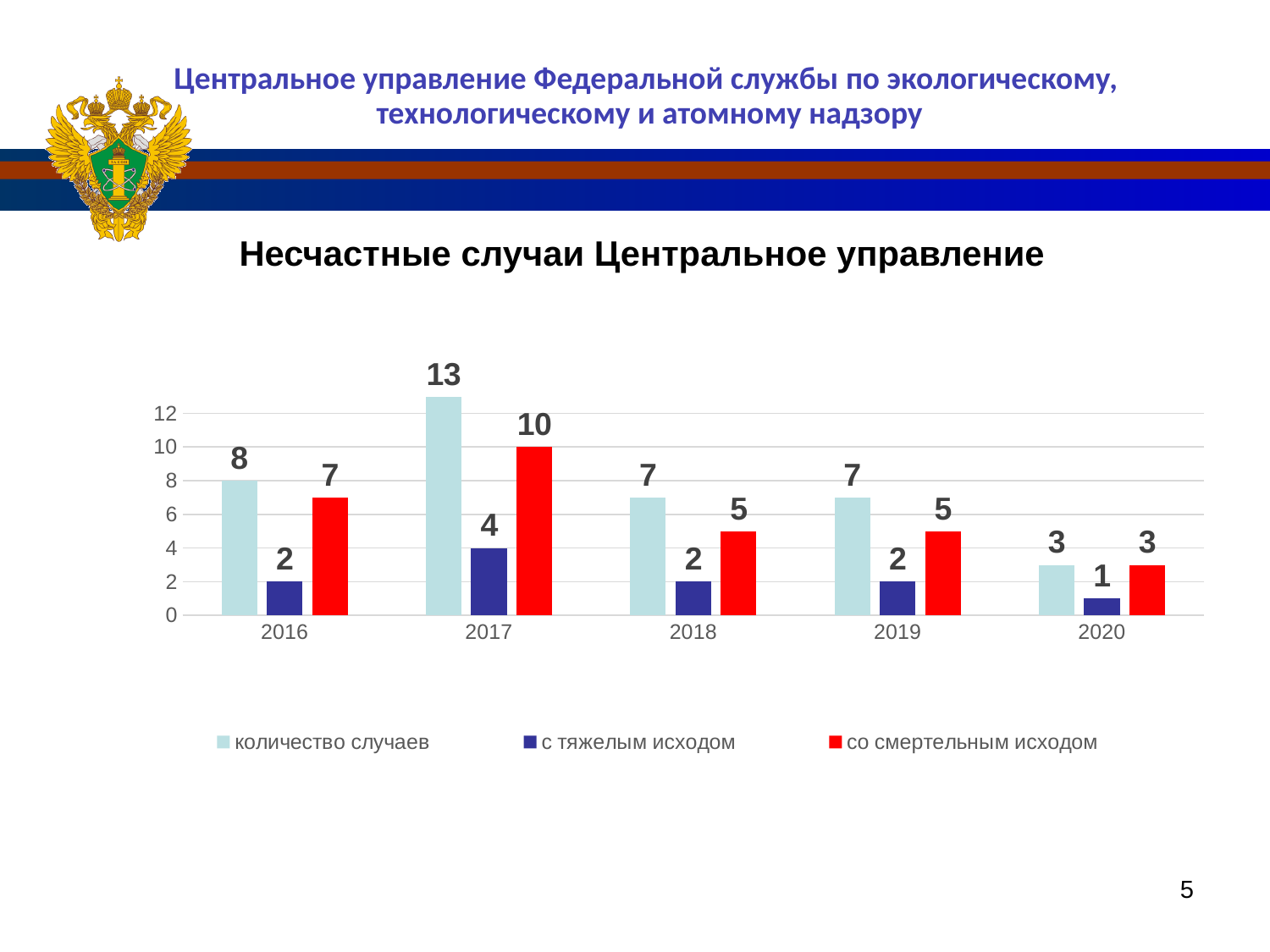
What is the value of "с тяжелым исходом" for 2020? 1 How many series does the legend list? 3 What is the difference between "количество случаев" in 2017 and in 2016? 5 What is the value of "количество случаев" for 2017? 13 What kind of chart is shown on the slide? bar chart Which year has the lowest value for "со смертельным исходом"? 2020 What is the value of "со смертельным исходом" for 2019? 5 Which is larger: "со смертельным исходом" in 2016 or in 2018? 2016 What is the title of the chart? Несчастные случаи Центральное управление Which year has the highest value for "количество случаев"? 2017 How many years are shown on the x axis? 5 Does the value of "количество случаев" rise or fall from 2017 to 2020? fall